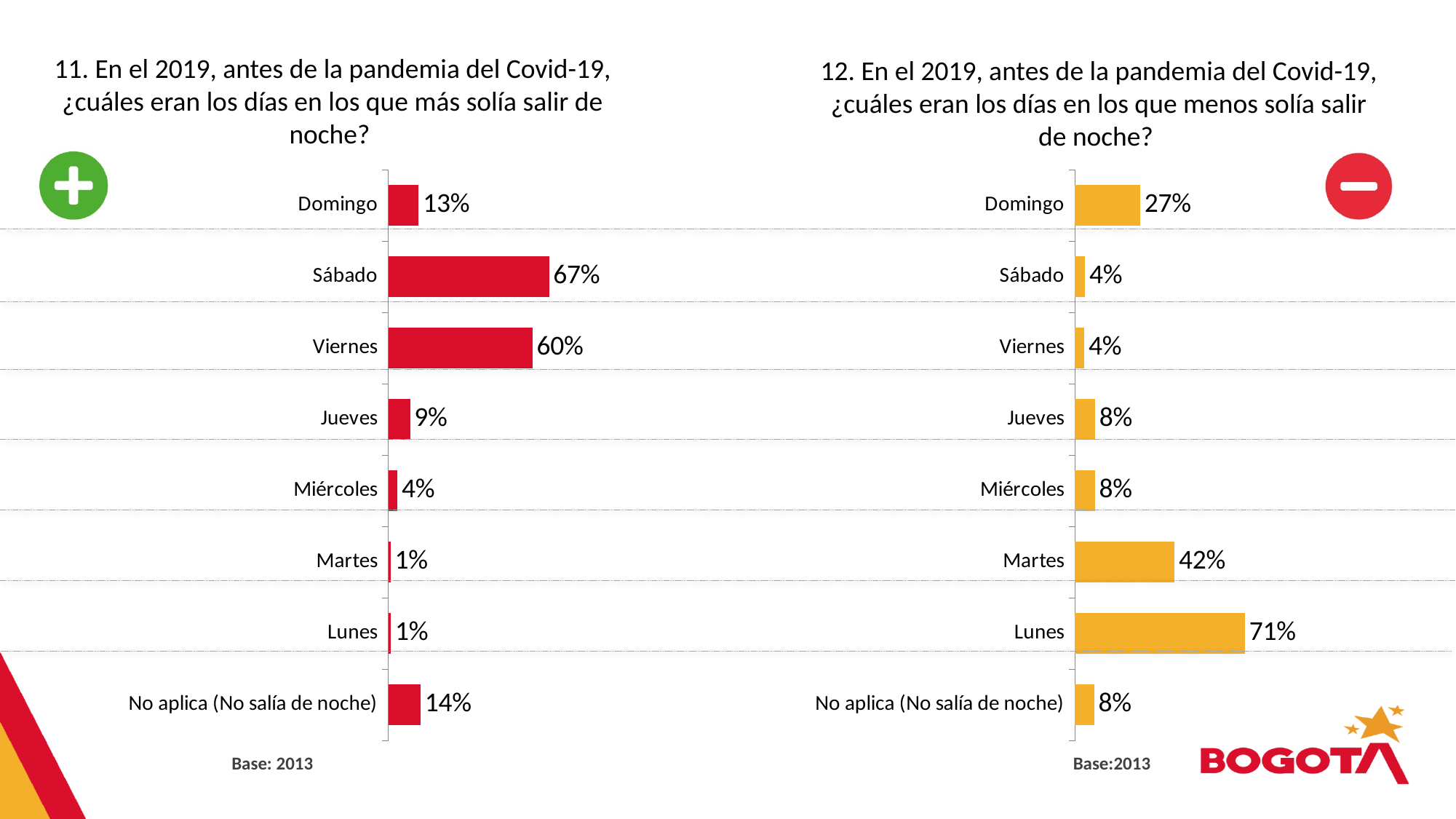
In the left chart (question 11, days most often went out at night), what is the value for Sábado? 67% How many categories are shown in the left chart (question 11)? 8 What kind of chart is the right chart (question 12)? Bar chart In the right chart (question 12), which is larger, the value for Martes or the value for Domingo? Martes In the left chart (question 11), which is larger, the value for Domingo or the value for No aplica (No salía de noche)? No aplica (No salía de noche) In the left chart (question 11), what is the difference between the values for Sábado and Viernes? 7% In the right chart (question 12), what is the difference between the values for Lunes and Martes? 29% In the right chart (question 12), what is the value for Domingo? 27% In the right chart (question 12), which category has the highest value? Lunes In the left chart (question 11), which category has the highest value? Sábado In the right chart (question 12, days least often went out at night), what is the value for Lunes? 71% What colour are the bars in the left chart (question 11)? Red